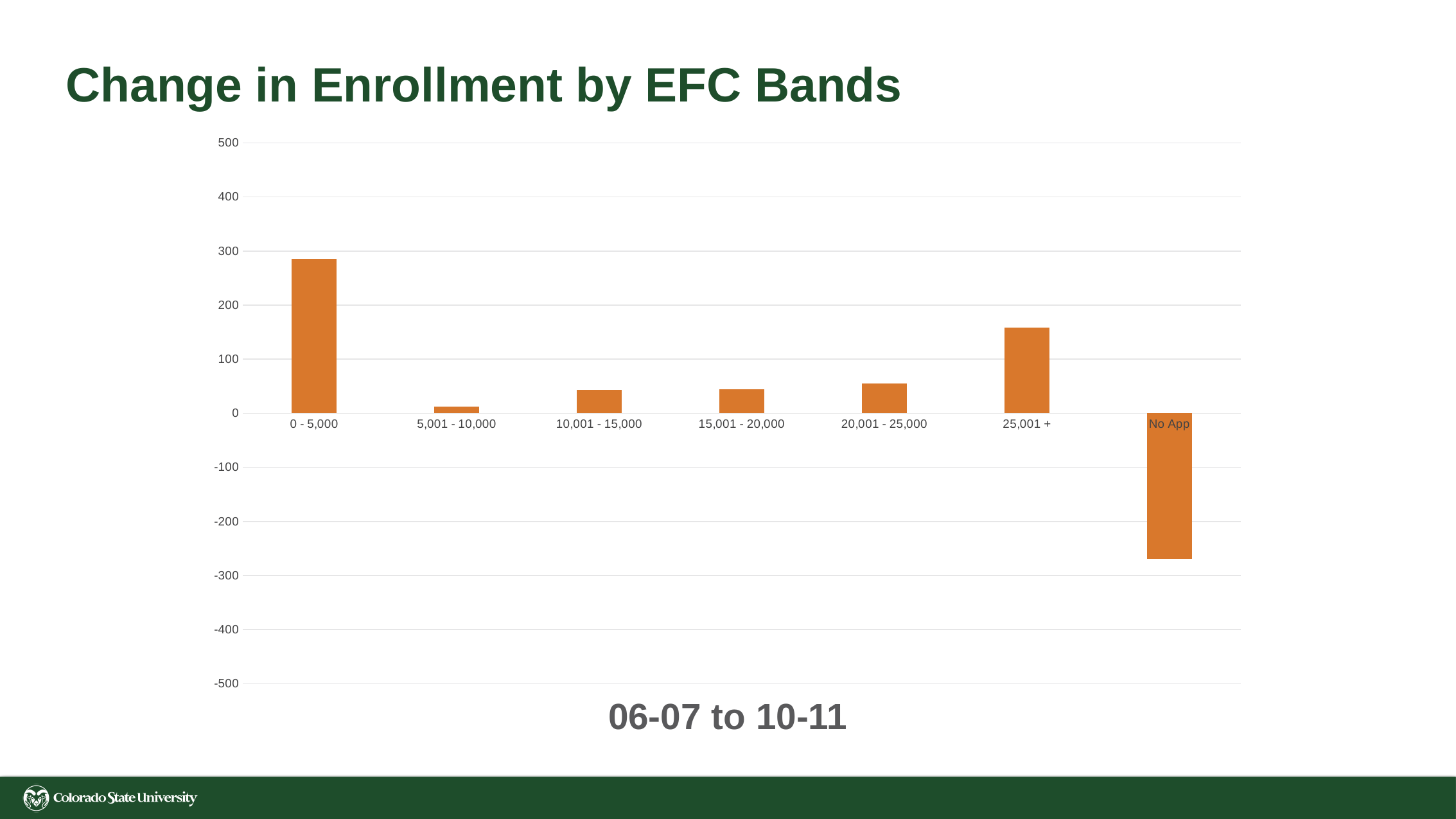
What kind of chart is shown on the slide? bar chart How many EFC band categories are plotted on the chart? 7 What is the title of the chart? Change in Enrollment by EFC Bands Is the value for 25,001 + greater or less than 200? less Which category has the lowest change in enrollment? No App Which is larger, the value for 0 - 5,000 or the value for 25,001 +? 0 - 5,000 Which is larger, the value for 20,001 - 25,000 or the value for 5,001 - 10,000? 20,001 - 25,000 Which EFC band has the highest change in enrollment? 0 - 5,000 What time period is shown in the text below the chart? 06-07 to 10-11 Is the value for 0 - 5,000 greater or less than 200? greater Is the value for 5,001 - 10,000 greater or less than 100? less